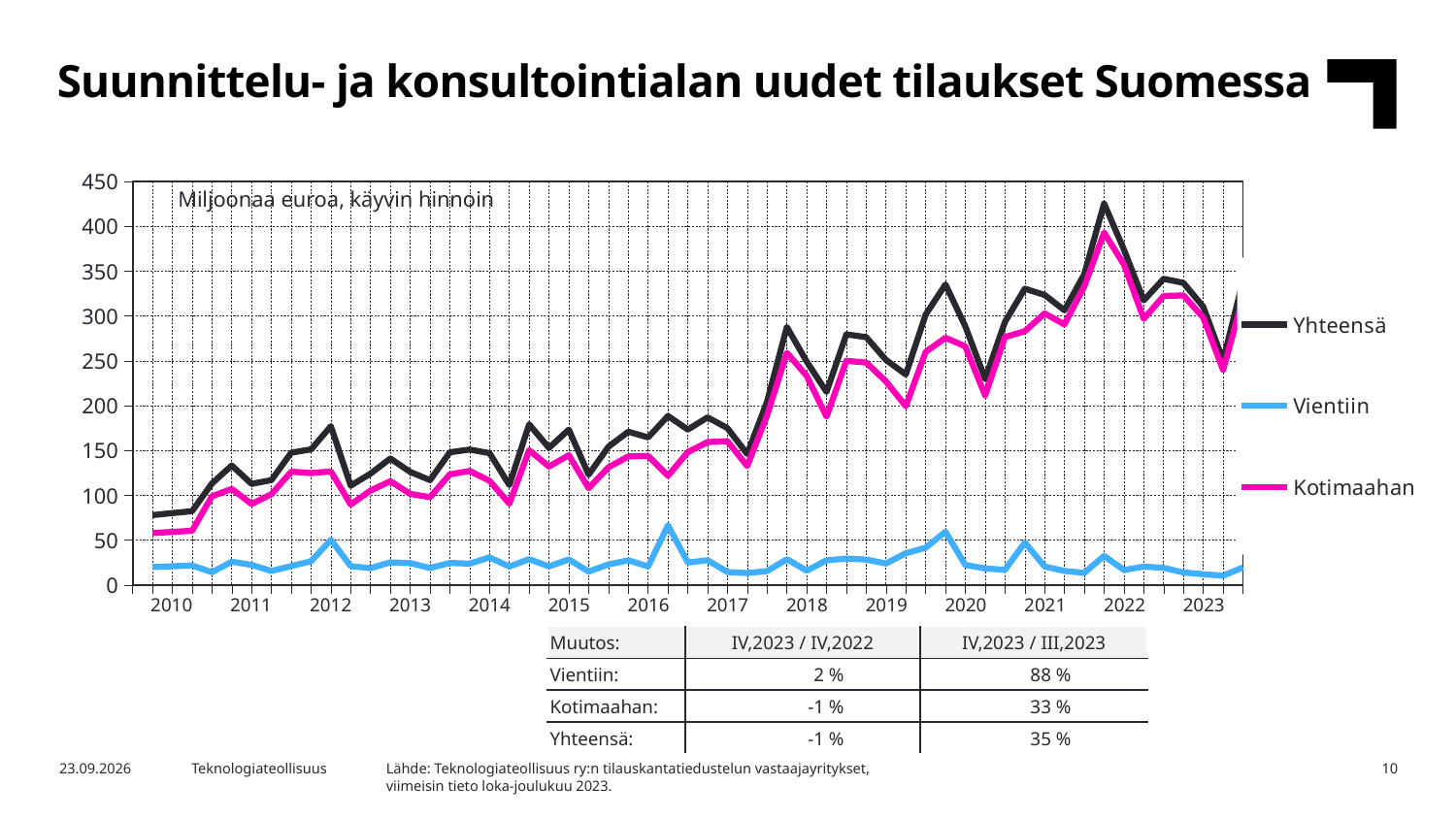
In 2020, which series has larger values, Kotimaahan or Vientiin? Kotimaahan What kind of chart is shown on the slide? Line chart Does the Yhteensä series overall rise or fall from 2010 to 2023? Rise How many series does the legend list? 3 Is the value of Yhteensä at the start of 2010 greater or less than 100? less Which series reaches the highest value on the chart? Yhteensä What unit label is printed inside the chart area? Miljoonaa euroa, käyvin hinnoin Which series are listed in the legend? Yhteensä, Vientiin, Kotimaahan Is the peak value of Yhteensä in late 2021 greater or less than 400? greater Is the highest value of Vientiin (in 2016) greater or less than 50? greater How many years are labelled on the x axis? 14 Which series stays lowest throughout the chart? Vientiin